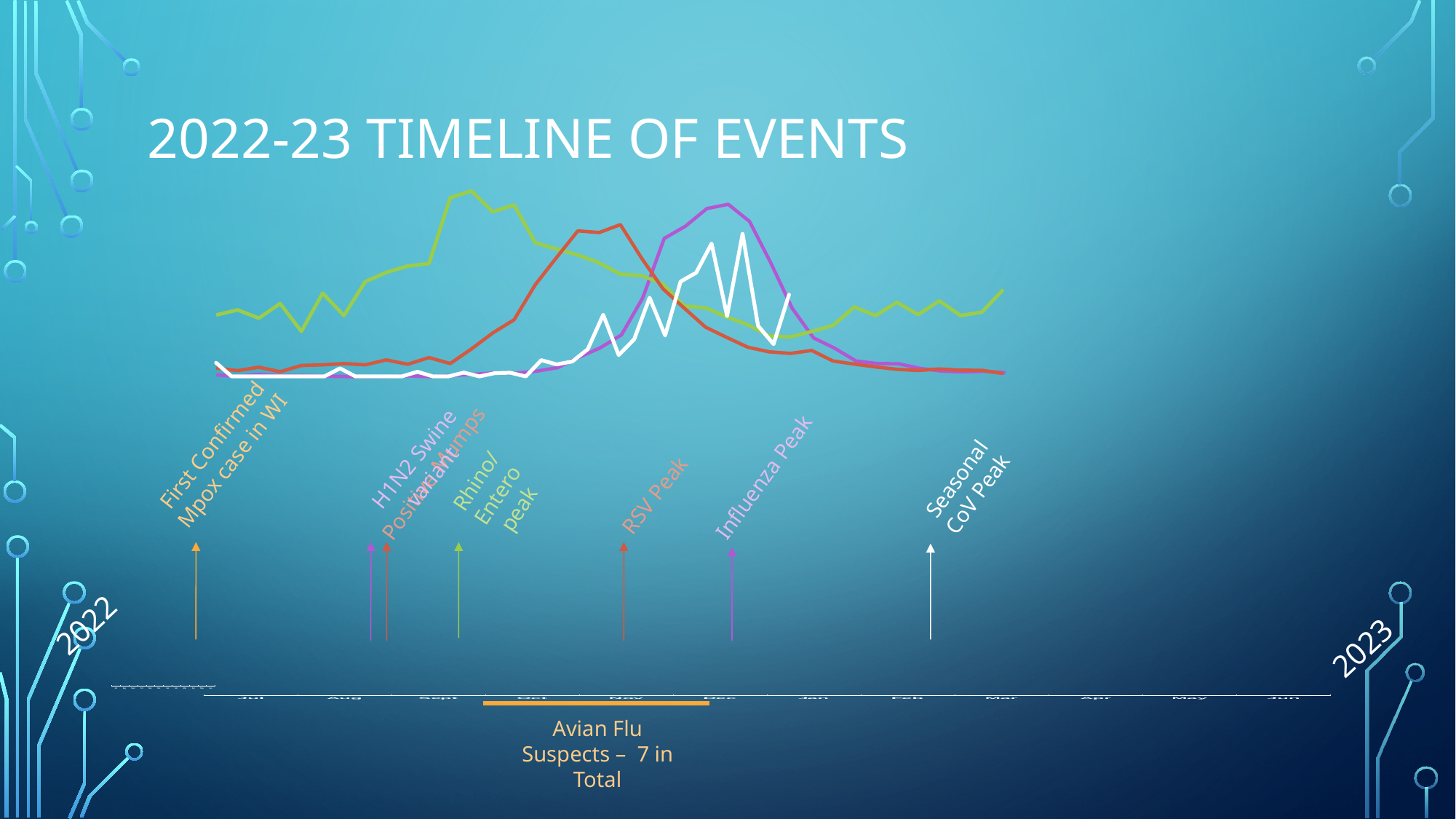
Which month label is first on the timeline axis? Jul Which line peaks latest along the timeline, the orange line or the purple line? purple line Which line reaches its peak earliest along the timeline, the green line or the purple line? green line How many lines are plotted on the chart? 4 Does the purple line rise or fall from Sept to its peak around Dec? rise According to the annotation under the timeline, how many Avian Flu suspects were there in total? 7 Which event is marked by the arrow nearest the Jul label on the timeline? First Confirmed Mpox case in WI What kind of chart is shown on the slide? line chart What is the title of the slide containing the chart? 2022-23 Timeline of Events Does the orange line rise or fall between its peak around Oct/Nov and Mar? fall How many month labels appear along the timeline axis? 12 Does the green line rise or fall from Jul to its peak around Sept? rise